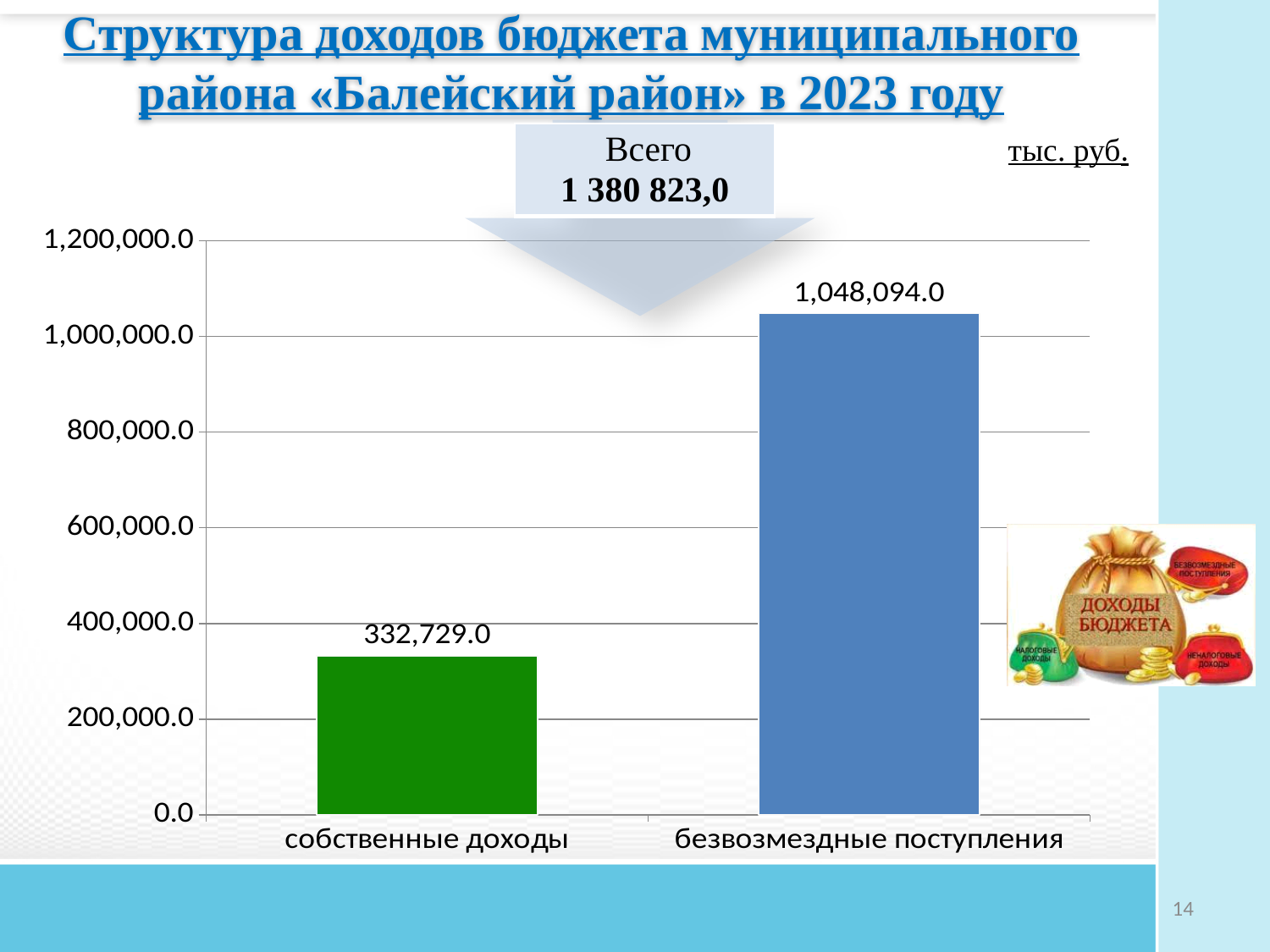
Which is larger, собственные доходы or безвозмездные поступления? безвозмездные поступления Which category has the highest value? безвозмездные поступления Which category has the lowest value? собственные доходы Is the value for безвозмездные поступления greater or less than 1,000,000.0? greater What is the difference between безвозмездные поступления and собственные доходы? 715,365.0 Is the value for собственные доходы greater or less than 400,000.0? less What colour is the bar for собственные доходы? green What is the value for безвозмездные поступления? 1,048,094.0 What is the value for собственные доходы? 332,729.0 What total (Всего) is shown above the chart? 1 380 823,0 What kind of chart is shown on the slide? bar chart How many categories are shown in the chart? 2